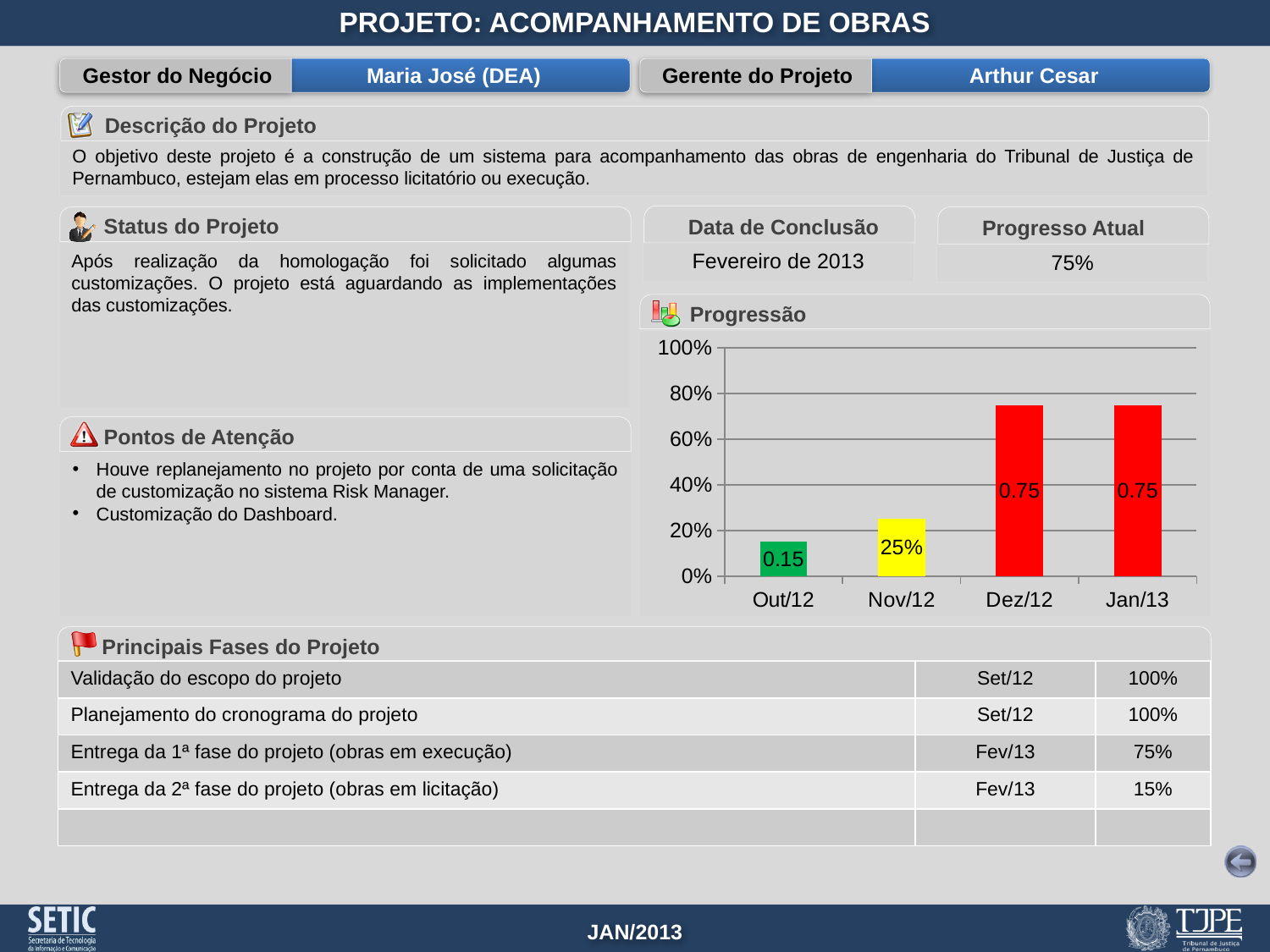
What kind of chart is the Progressão chart? bar chart Do the values in the Progressão chart rise or fall from Out/12 to Dez/12? rise What is the value shown for Nov/12 in the Progressão chart? 25% In the Progressão chart, what is the difference between the values for Dez/12 and Out/12? 0.6 How many months are shown on the x axis of the Progressão chart? 4 In the Progressão chart, which is larger: the value for Nov/12 or the value for Out/12? Nov/12 What is the value shown for Jan/13 in the Progressão chart? 0.75 In the Progressão chart, is the value for Dez/12 greater or less than 60%? greater In the Progressão chart, is the value for Nov/12 greater or less than 40%? less What is the value shown for Dez/12 in the Progressão chart? 0.75 What is the value shown for Out/12 in the Progressão chart? 0.15 Which month has the lowest value in the Progressão chart? Out/12